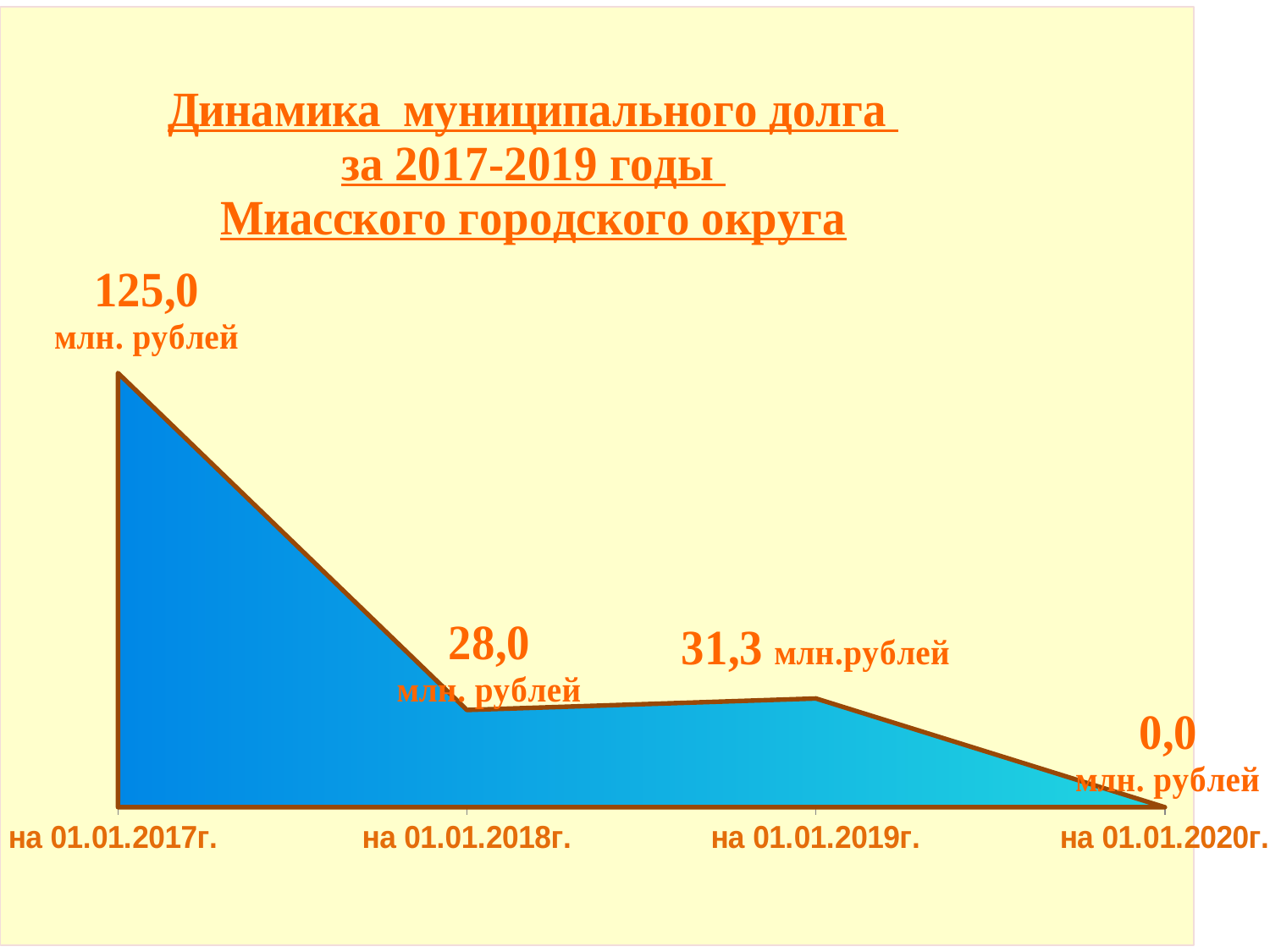
What type of chart is shown on the slide? Area chart What is the municipal debt on 01.01.2020 (на 01.01.2020г.)? 0,0 млн. рублей Which is larger: the debt on 01.01.2018 or on 01.01.2019? на 01.01.2019г. On which date is the municipal debt lowest? на 01.01.2020г. By how much did the municipal debt decrease from 01.01.2017 to 01.01.2018? 97,0 млн. рублей On which date is the municipal debt highest? на 01.01.2017г. What is the municipal debt on 01.01.2019 (на 01.01.2019г.)? 31,3 млн.рублей What is the municipal debt on 01.01.2017 (на 01.01.2017г.)? 125,0 млн. рублей What is the difference between the debt on 01.01.2019 and on 01.01.2018? 3,3 млн. рублей What is the title of the chart? Динамика муниципального долга за 2017-2019 годы Миасского городского округа What is the municipal debt on 01.01.2018 (на 01.01.2018г.)? 28,0 млн. рублей How many dates (data points) are shown on the chart? 4